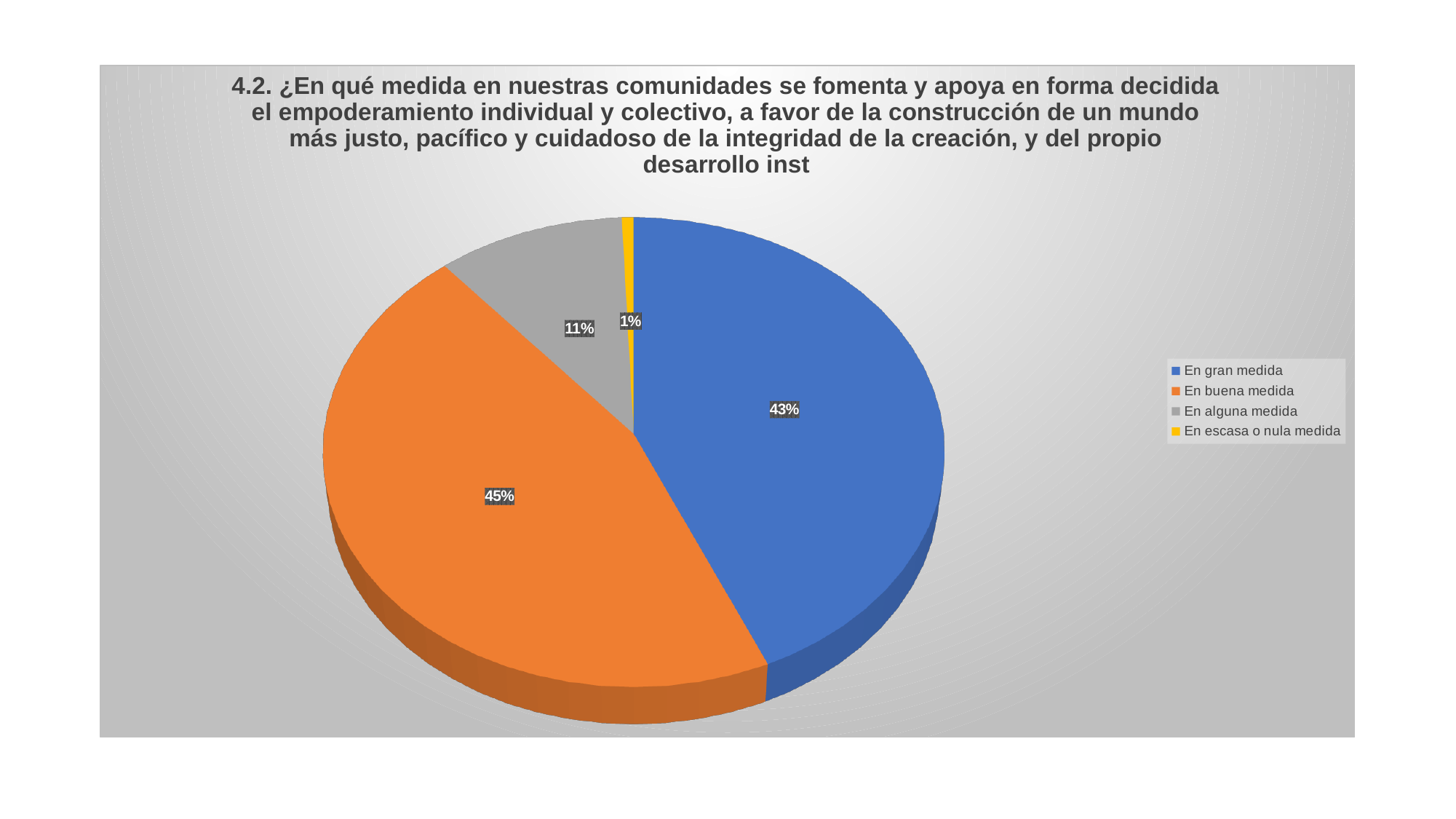
What percentage is shown for "En buena medida"? 45% What percentage is shown for "En gran medida"? 43% How many categories does the legend list? 4 What percentage is shown for "En alguna medida"? 11% Which category has the smallest share of the pie? En escasa o nula medida What is the difference in percentage points between "En buena medida" and "En alguna medida"? 34 Which category has the largest share of the pie? En buena medida What colour is the slice for "En alguna medida"? Grey What colour is the slice for "En escasa o nula medida"? Yellow Which is larger, the share for "En gran medida" or the share for "En alguna medida"? En gran medida What type of chart is shown on the slide? Pie chart What percentage is shown for "En escasa o nula medida"? 1%